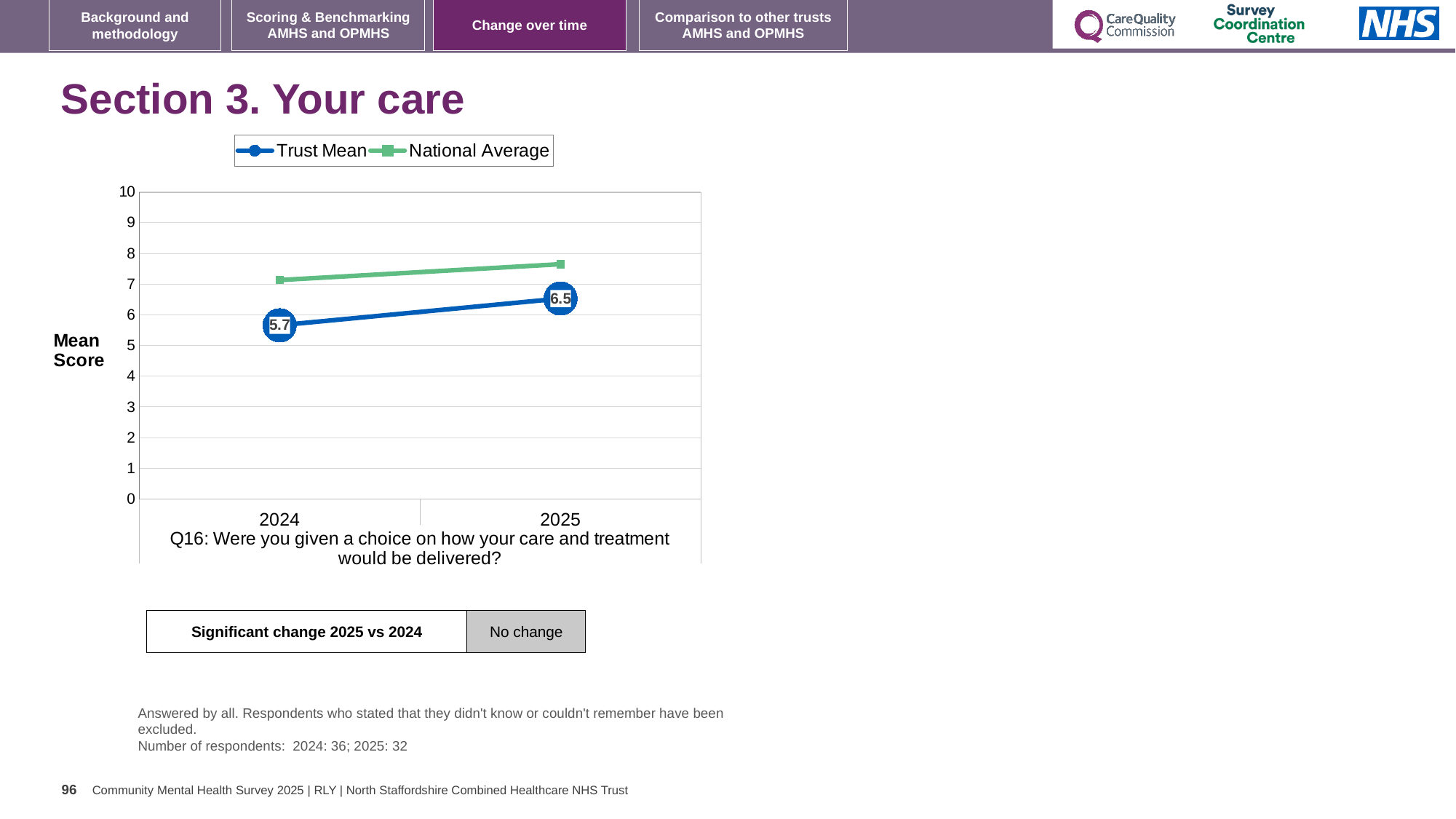
How many series does the legend list? 2 What is the label of the y axis? Mean Score Which year has the higher Trust Mean score, 2024 or 2025? 2025 What kind of chart is shown on the slide? line chart Is the National Average for 2025 greater or less than 8? less In 2025, which is higher, the Trust Mean or the National Average? National Average How many years are shown on the x axis? 2 What is the Trust Mean score for 2025? 6.5 Does the Trust Mean rise or fall from 2024 to 2025? rise By how much did the Trust Mean change from 2024 to 2025? 0.8 What is the Trust Mean score for 2024? 5.7